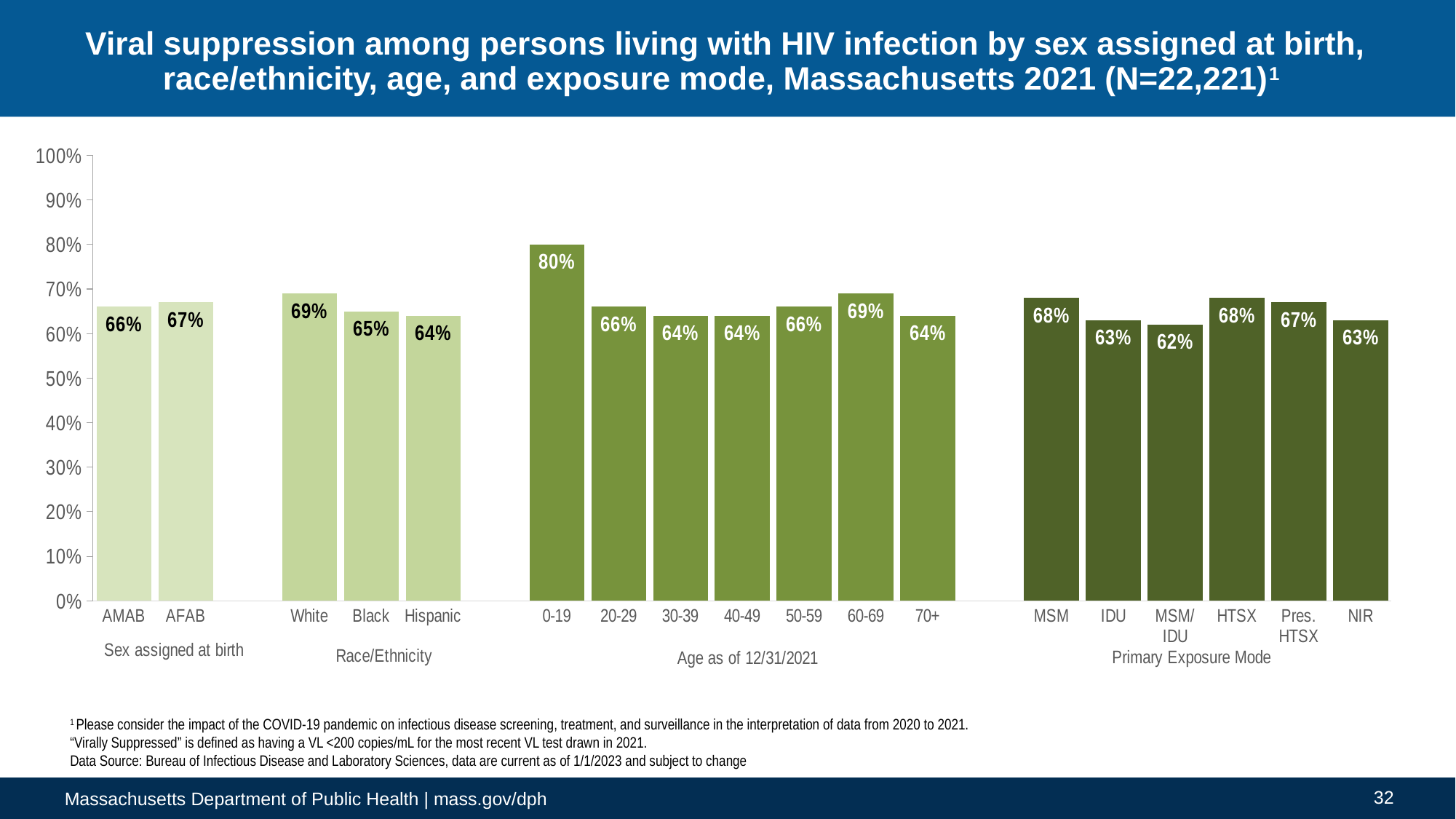
What is the viral suppression percentage for Black persons? 65% What kind of chart is shown on the slide? Bar chart How many age groups are shown on the chart? 7 Is the value for the 0-19 age group greater or less than 70%? greater What is the viral suppression percentage for MSM/IDU? 62% What is the difference in viral suppression percentage between the 0-19 and 20-29 age groups? 14% How many primary exposure mode categories are shown on the chart? 6 Which has a higher viral suppression percentage, White or Hispanic? White What is the viral suppression percentage for the 0-19 age group? 80% Which category on the chart has the highest viral suppression percentage? 0-19 Which primary exposure mode has the lowest viral suppression percentage? MSM/IDU What is the viral suppression percentage for AFAB? 67%